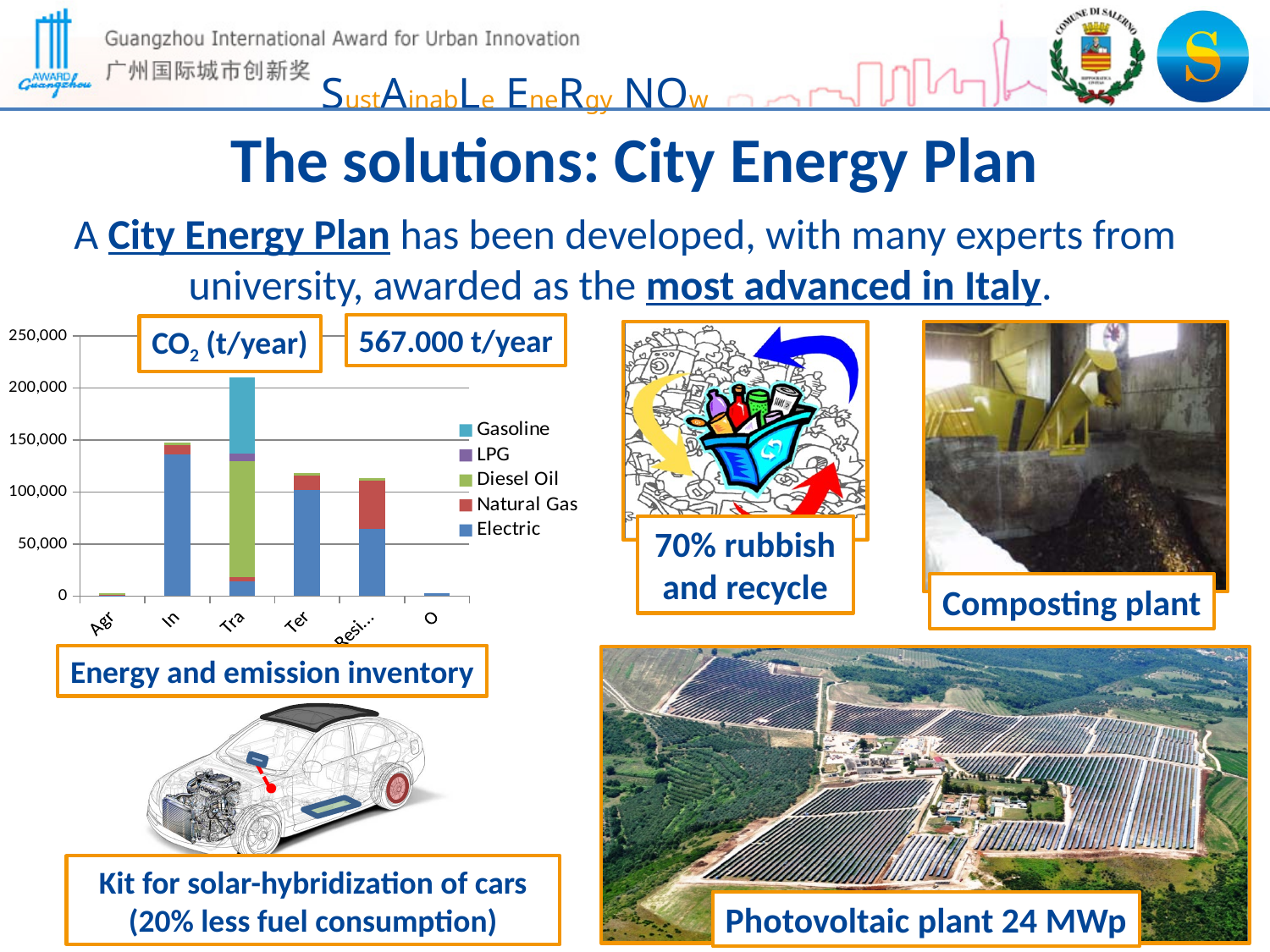
What is the title shown on the chart? CO2 (t/year) Which category has the highest total stacked bar in the chart? Tra Is the total value for Ter greater or less than 100,000? greater Which series is listed first in the chart legend? Gasoline Is the total value for Agr greater or less than 50,000? less Is the total value for Tra greater or less than 200,000? greater How many categories are shown along the x axis of the chart? 6 How many series does the chart legend list? 5 What kind of chart is shown on the slide? Stacked bar chart Which series makes up the largest part of the Tra bar? Diesel Oil Which has the larger total stacked bar, In or Ter? In